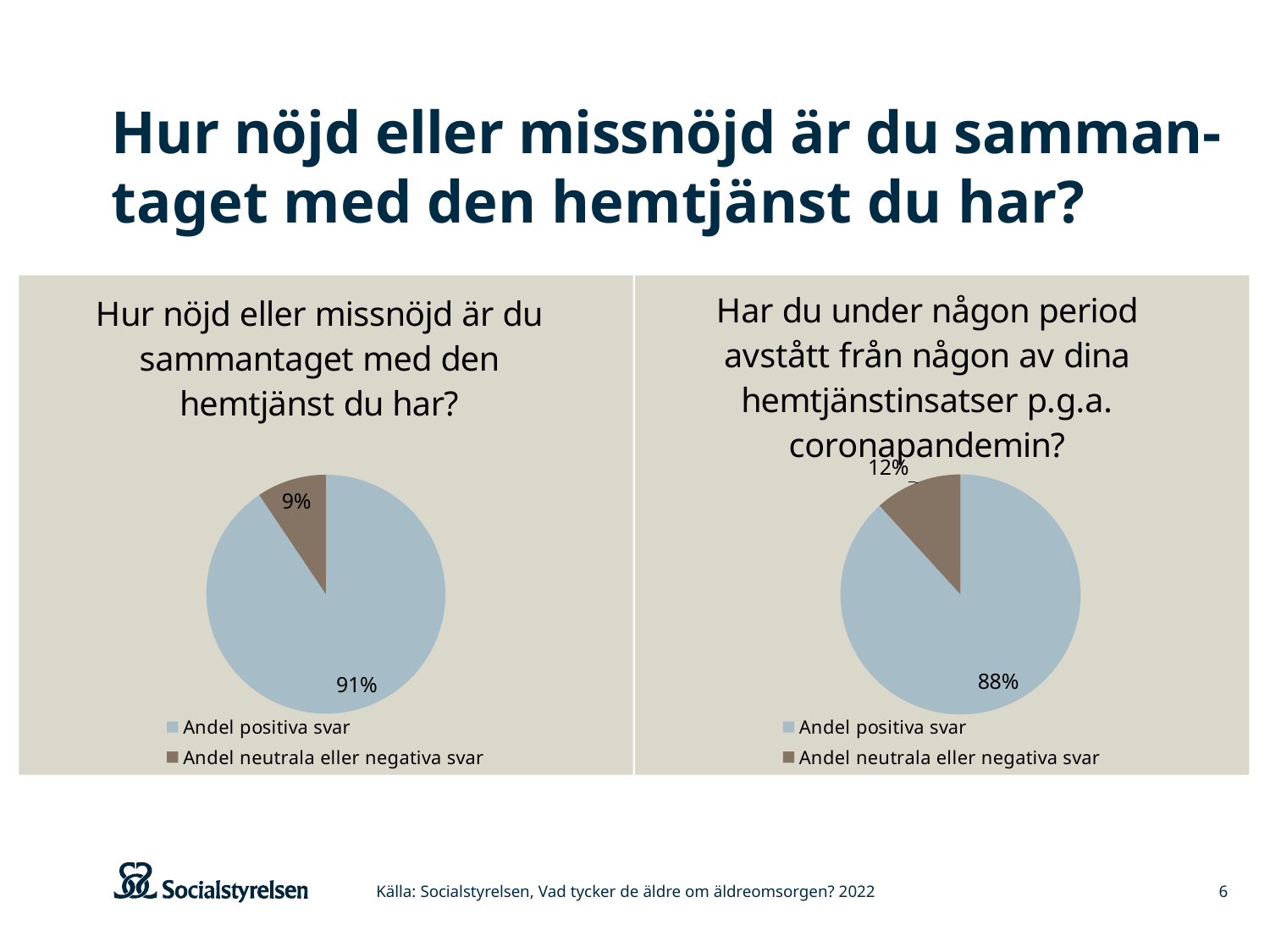
In the right pie chart, which category has the smallest share? Andel neutrala eller negativa svar In the left pie chart ("Hur nöjd eller missnöjd är du sammantaget med den hemtjänst du har?"), what is the value for "Andel neutrala eller negativa svar"? 9% In the left pie chart ("Hur nöjd eller missnöjd är du sammantaget med den hemtjänst du har?"), what is the value for "Andel positiva svar"? 91% What colour is the "Andel neutrala eller negativa svar" slice in the right pie chart? Brown In the left pie chart, which category has the largest share? Andel positiva svar Which is larger: "Andel positiva svar" in the left pie chart or "Andel positiva svar" in the right pie chart? Left pie chart (91%) How many slices does the right pie chart have? 2 How many entries does the legend of the left pie chart list? 2 In the right pie chart ("Har du under någon period avstått från någon av dina hemtjänstinsatser p.g.a. coronapandemin?"), what is the value for "Andel neutrala eller negativa svar"? 12% In the right pie chart ("Har du under någon period avstått från någon av dina hemtjänstinsatser p.g.a. coronapandemin?"), what is the value for "Andel positiva svar"? 88% What type of chart is shown on the left side of the slide? Pie chart In the left pie chart, what is the difference between "Andel positiva svar" and "Andel neutrala eller negativa svar"? 82%